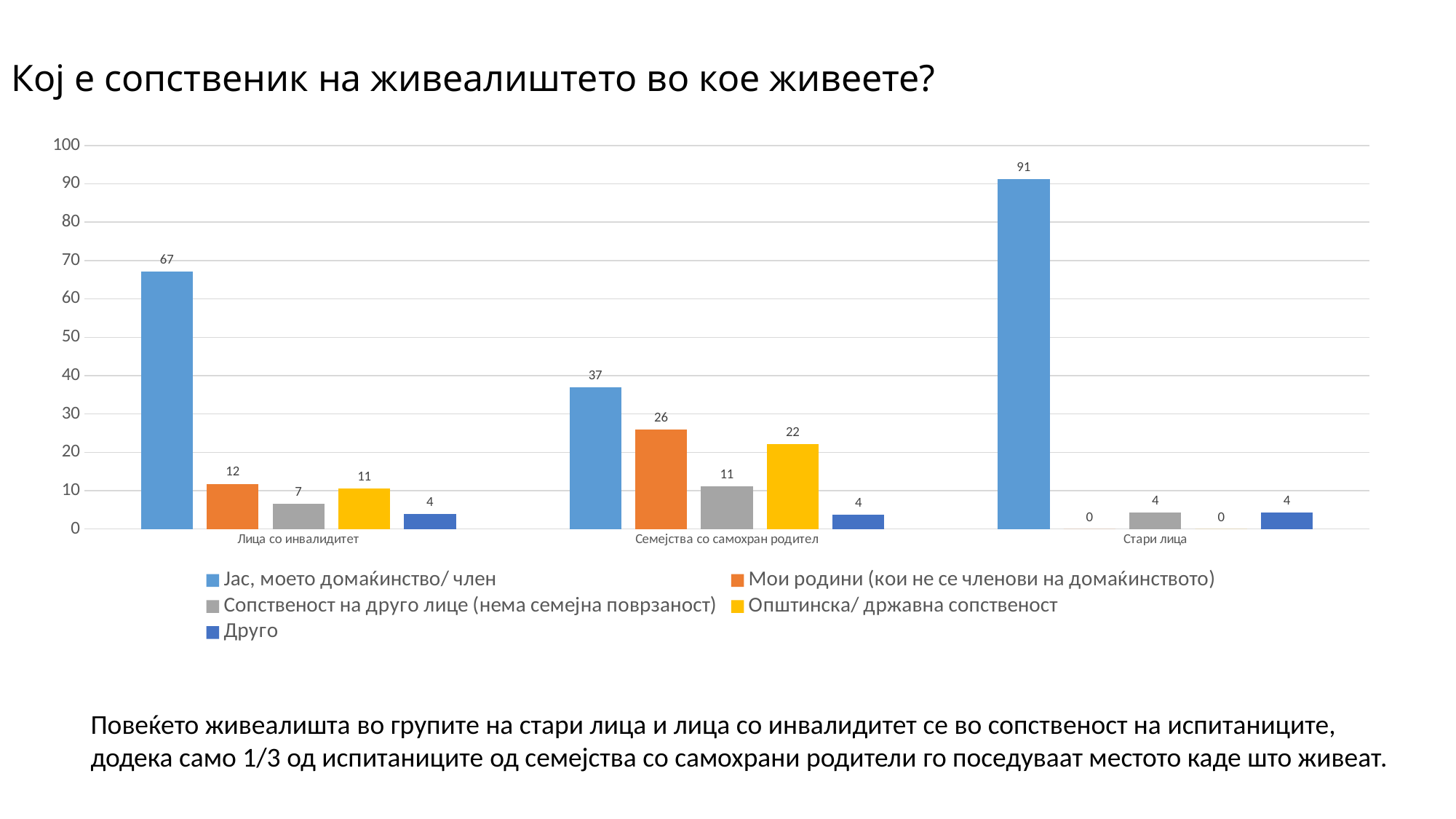
What is the value for "Јас, моето домаќинство/ член" in the "Стари лица" category? 91 How many categories are shown on the x axis? 3 What is the value for "Друго" in the "Стари лица" category? 4 What is the title of the slide? Кој е сопственик на живеалиштето во кое живеете? How many series does the legend list? 5 What kind of chart is shown on the slide? Bar chart What is the value for "Мои родини (кои не се членови на домаќинството)" in the "Семејства со самохран родител" category? 26 Which category has the lowest value for "Општинска/ државна сопственост"? Стари лица What is the value for "Општинска/ државна сопственост" in the "Лица со инвалидитет" category? 11 What is the difference between the "Јас, моето домаќинство/ член" values for "Стари лица" and "Лица со инвалидитет"? 24 Which category has the highest value for "Јас, моето домаќинство/ член"? Стари лица Which is larger in the "Семејства со самохран родител" category: "Мои родини (кои не се членови на домаќинството)" or "Општинска/ државна сопственост"? Мои родини (кои не се членови на домаќинството)